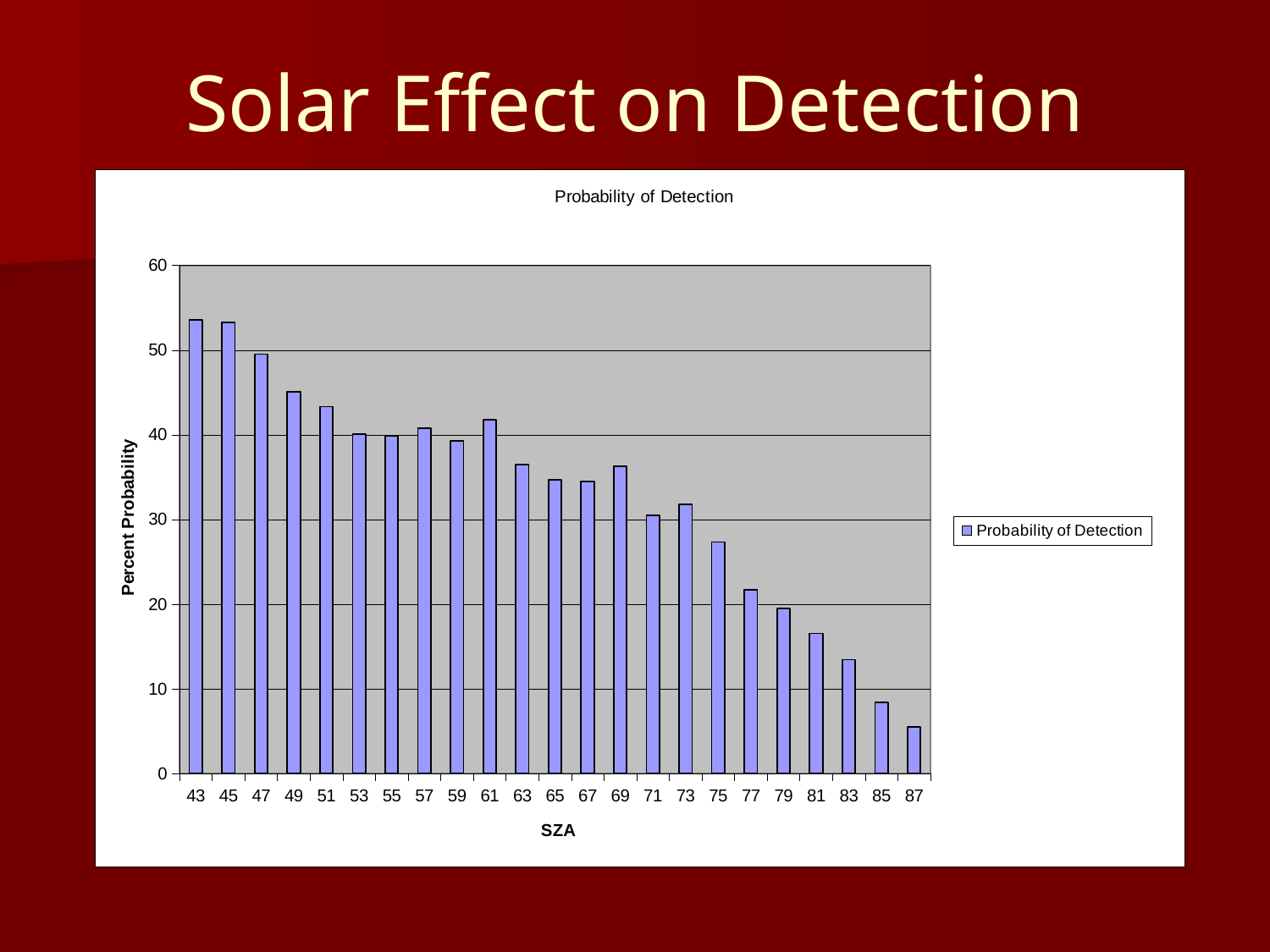
Which has the higher probability of detection, SZA 47 or SZA 49? 47 Is the value for SZA 75 greater or less than 30? less How many bars (SZA categories) are plotted in the chart? 23 What kind of chart is shown on the slide? bar chart What is the label on the vertical axis of the chart? Percent Probability Which has the higher probability of detection, SZA 61 or SZA 63? 61 How many series does the legend list? 1 What is the title of the chart? Probability of Detection Is the value for SZA 43 greater or less than 50? greater Is the value for SZA 87 greater or less than 10? less Which SZA value has the lowest probability of detection? 87 Do the values generally rise or fall as SZA increases along the x axis? fall